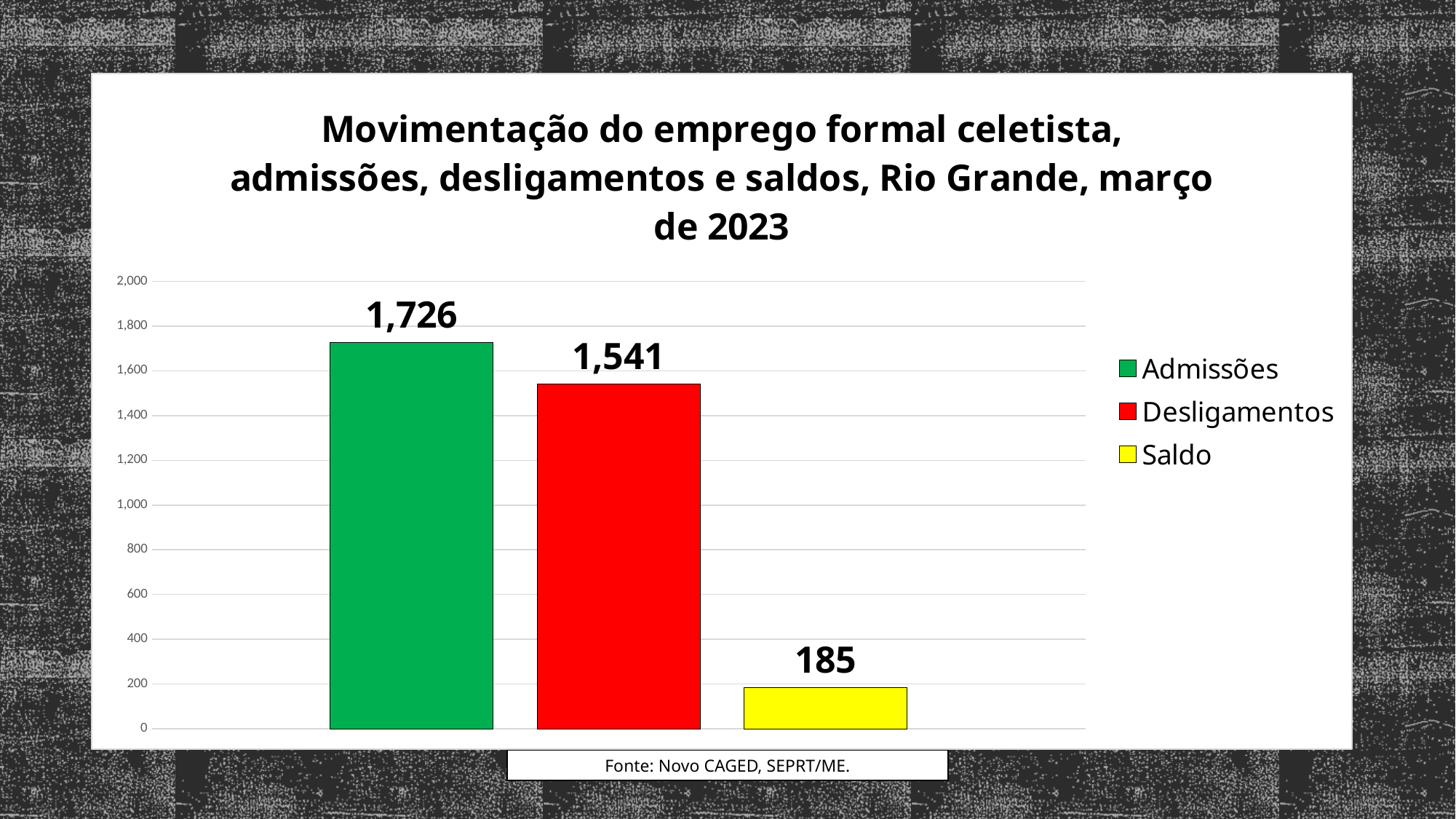
What is the value for Saldo? 185 What is the value for Desligamentos? 1,541 What is the difference between Admissões and Desligamentos? 185 Which series has the highest value? Admissões How many series does the legend list? 3 What kind of chart is shown on the slide? bar chart How many bars are plotted in the chart? 3 Which series has the lowest value? Saldo Which is larger, Admissões or Desligamentos? Admissões What colour is the bar for Saldo? yellow What is the value for Admissões? 1,726 Is the value for Desligamentos greater or less than 1,600? less